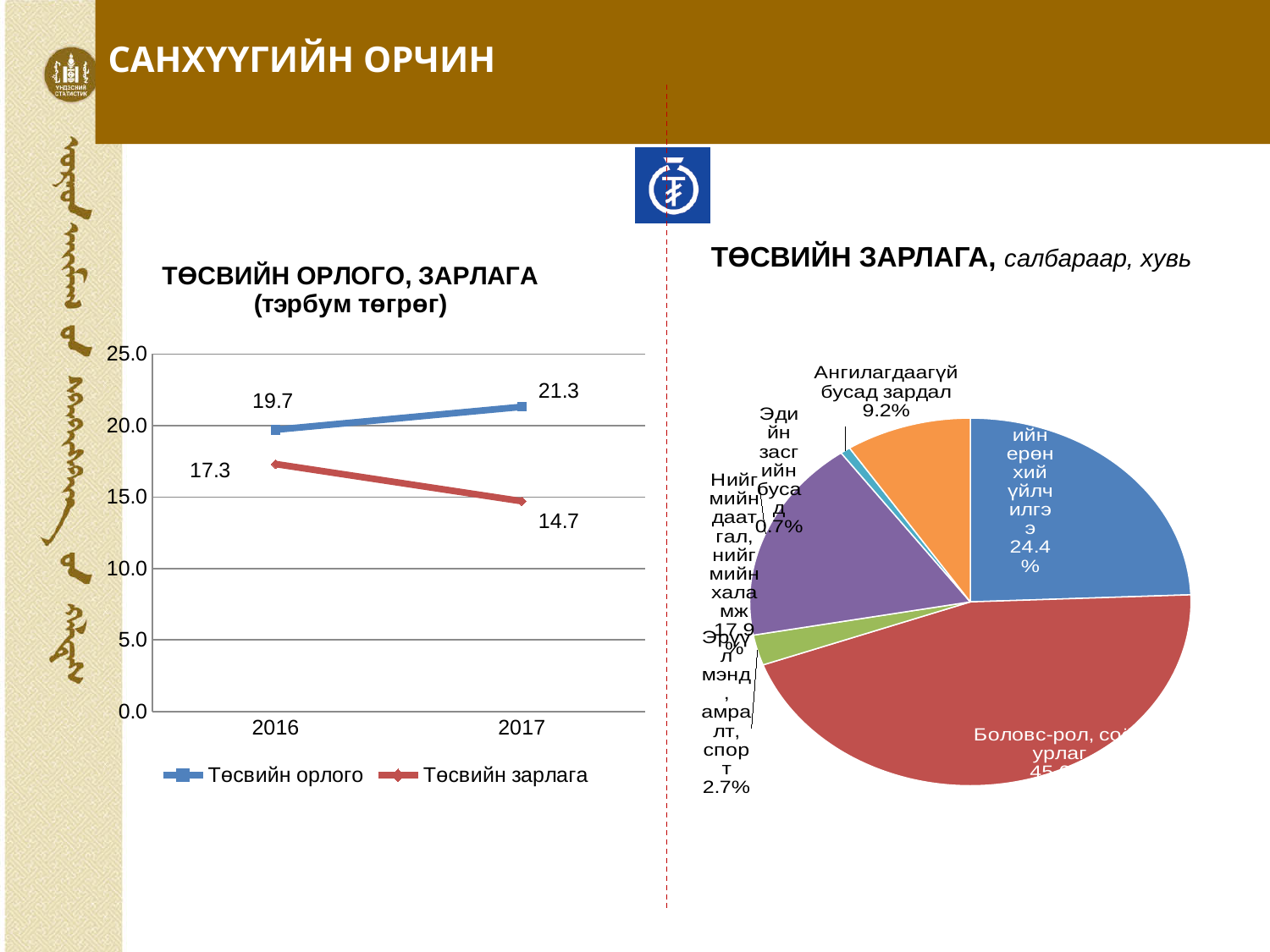
On the line chart 'ТӨСВИЙН ОРЛОГО, ЗАРЛАГА', what is the difference between Төсвийн орлого and Төсвийн зарлага in 2017? 6.6 On the line chart 'ТӨСВИЙН ОРЛОГО, ЗАРЛАГА', which is larger in 2016: Төсвийн орлого or Төсвийн зарлага? Төсвийн орлого What kind of chart is 'ТӨСВИЙН ЗАРЛАГА, салбараар, хувь'? pie chart On the line chart 'ТӨСВИЙН ОРЛОГО, ЗАРЛАГА', what is the value of Төсвийн зарлага in 2017? 14.7 On the pie chart 'ТӨСВИЙН ЗАРЛАГА, салбараар, хувь', what share is Нийгмийн даатгал, нийгмийн халамж? 17.9% On the line chart 'ТӨСВИЙН ОРЛОГО, ЗАРЛАГА', what is the value of Төсвийн зарлага in 2016? 17.3 On the line chart 'ТӨСВИЙН ОРЛОГО, ЗАРЛАГА', by how much did Төсвийн орлого increase from 2016 to 2017? 1.6 On the line chart 'ТӨСВИЙН ОРЛОГО, ЗАРЛАГА', does Төсвийн зарлага rise or fall from 2016 to 2017? fall On the pie chart 'ТӨСВИЙН ЗАРЛАГА, салбараар, хувь', what share is Ангилагдаагүй бусад зардал? 9.2% On the line chart 'ТӨСВИЙН ОРЛОГО, ЗАРЛАГА', how many series does the legend list? 2 On the pie chart 'ТӨСВИЙН ЗАРЛАГА, салбараар, хувь', which slice is the largest? Боловсрол, соёл урлаг On the line chart 'ТӨСВИЙН ОРЛОГО, ЗАРЛАГА', what is the value of Төсвийн орлого in 2017? 21.3